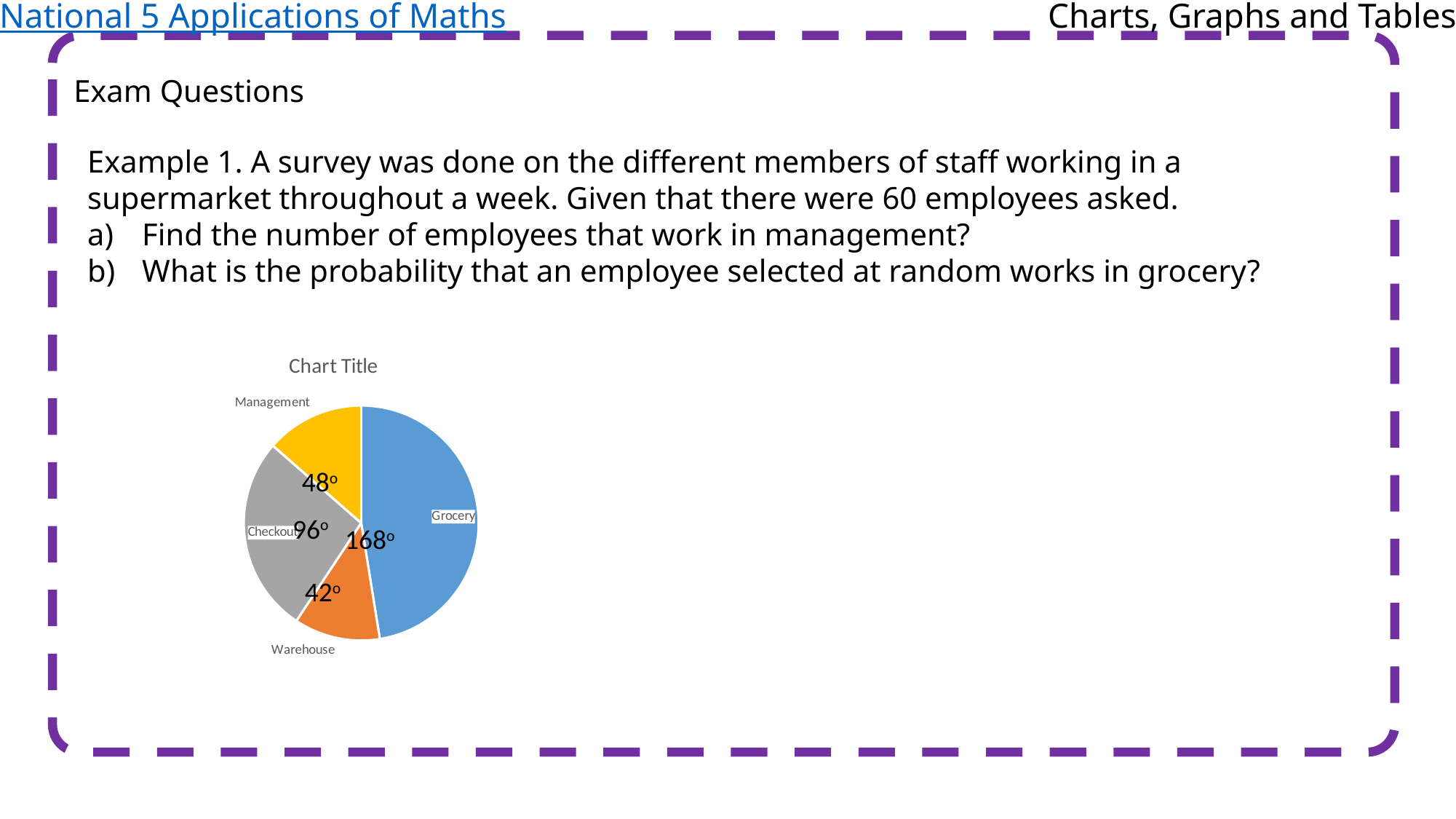
What kind of chart is shown on the slide? pie chart Which slice of the pie chart is the largest? Grocery What angle is shown for the Management slice of the pie chart? 48° What is the difference in degrees between the Grocery slice and the Checkout slice? 72° What angle is shown for the Warehouse slice of the pie chart? 42° How many slices does the pie chart have? 4 What angle is shown for the Checkout slice of the pie chart? 96° What angle is shown for the Grocery slice of the pie chart? 168° Which slice of the pie chart is the smallest? Warehouse What colour is the Grocery slice of the pie chart? blue Which slice is larger, Checkout or Management? Checkout What is the difference in degrees between the Management slice and the Warehouse slice? 6°